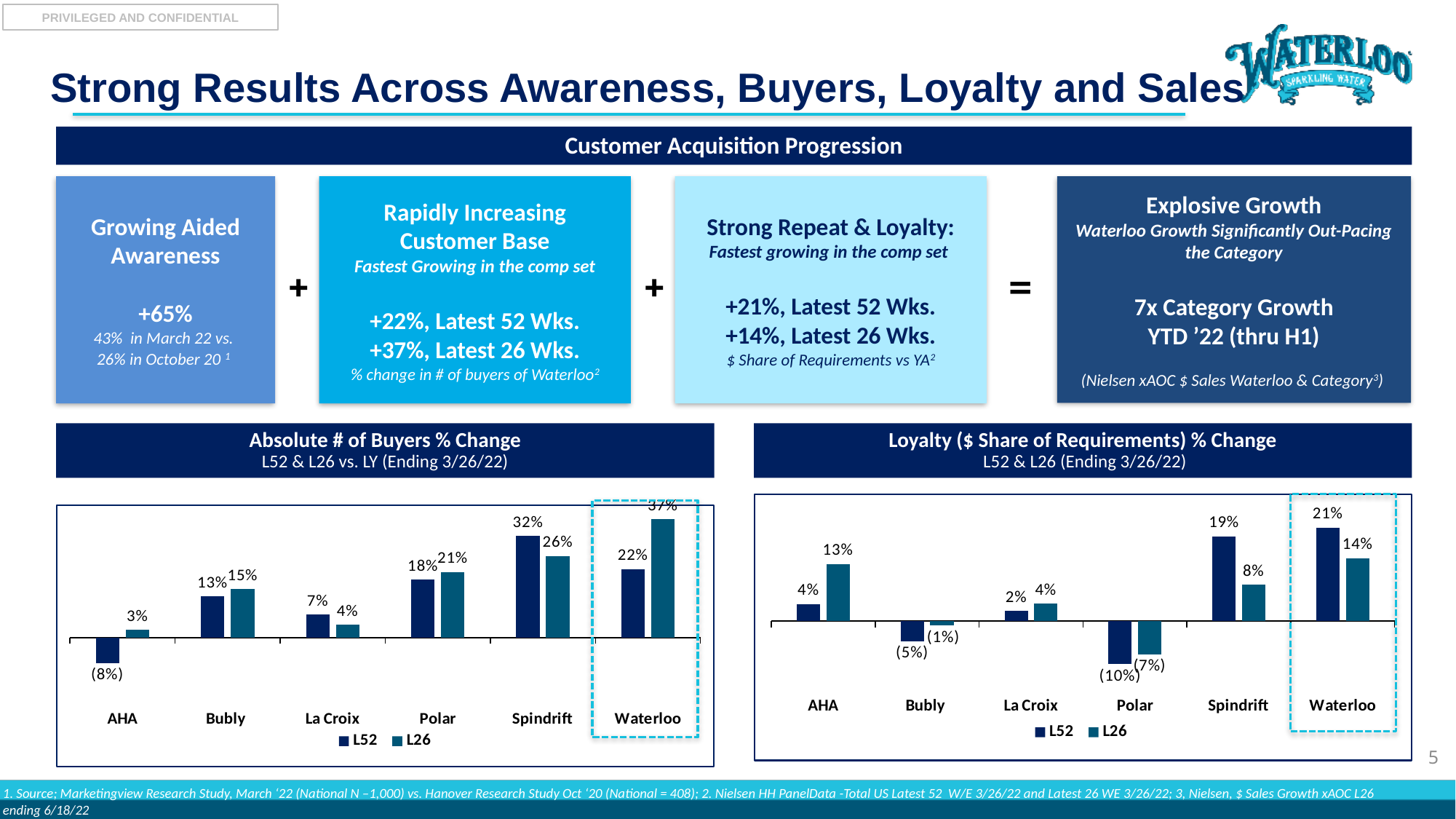
In the 'Absolute # of Buyers % Change' chart, what is the L52 value for AHA? (8%) In the 'Loyalty ($ Share of Requirements) % Change' chart, which brand has the highest L26 value? Waterloo In the 'Absolute # of Buyers % Change' chart, what is the L26 value for Waterloo? 37% What type of chart is the 'Absolute # of Buyers % Change' chart? Bar chart In the 'Absolute # of Buyers % Change' chart, which brand has the lowest L26 value? AHA How many series does the legend list in the 'Loyalty ($ Share of Requirements) % Change' chart? 2 In the 'Loyalty ($ Share of Requirements) % Change' chart, what is the L52 value for Polar? (10%) In the 'Absolute # of Buyers % Change' chart, which brand has the highest L52 value? Spindrift In the 'Loyalty ($ Share of Requirements) % Change' chart, is the L52 value for Spindrift larger or smaller than the L26 value for Spindrift? larger In the 'Absolute # of Buyers % Change' chart, how many brands are shown on the x axis? 6 In the 'Absolute # of Buyers % Change' chart, what is the difference between the L26 and L52 values for Waterloo? 15 percentage points In the 'Loyalty ($ Share of Requirements) % Change' chart, what is the L52 value for Waterloo? 21%